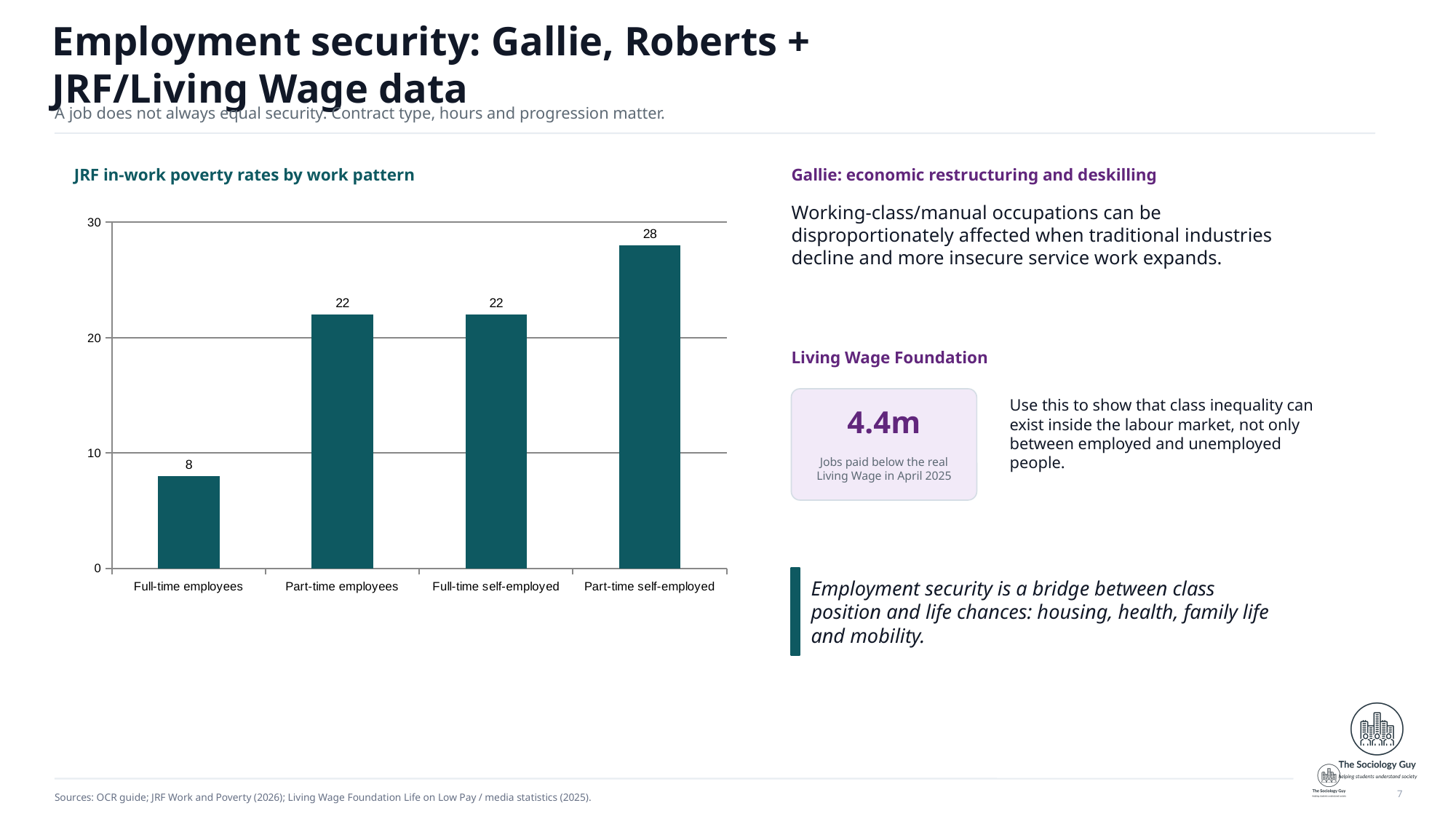
Which has a higher in-work poverty rate, Part-time self-employed or Full-time self-employed? Part-time self-employed What is the in-work poverty rate for Full-time employees? 8 What is the in-work poverty rate for Part-time employees? 22 What kind of chart is used to show the JRF in-work poverty rates? Bar chart What is the highest value shown on the chart's vertical axis? 30 Which work pattern has the lowest in-work poverty rate? Full-time employees What is the difference between the in-work poverty rates for Part-time self-employed and Full-time employees? 20 Which work pattern has the highest in-work poverty rate? Part-time self-employed Is the value for Full-time employees greater or less than 10? less How many work pattern categories are shown in the chart? 4 What is the in-work poverty rate for Part-time self-employed? 28 What is the title of the chart? JRF in-work poverty rates by work pattern